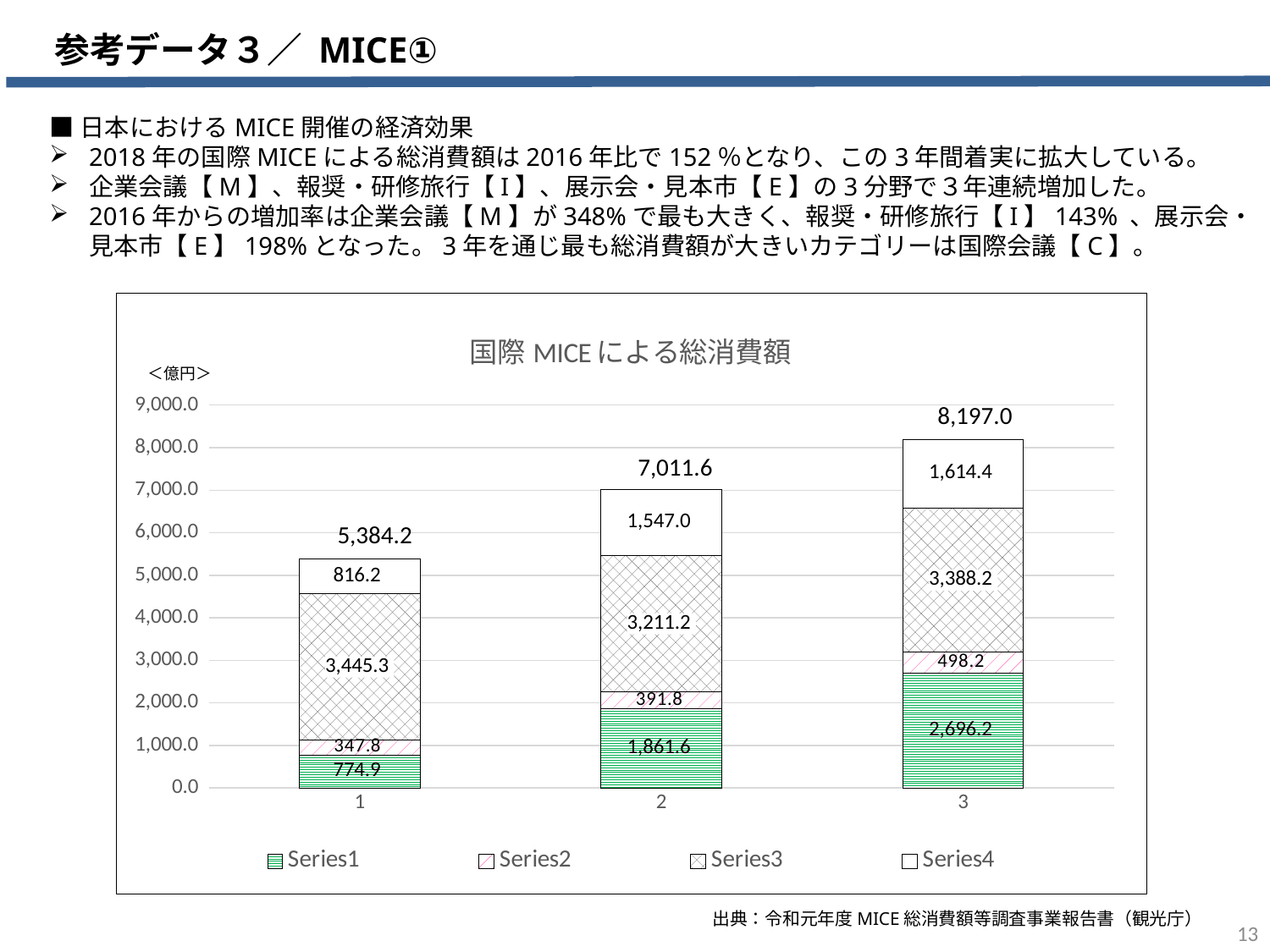
Do the totals rise or fall from category 1 to category 3? Rise How many categories are shown on the x axis? 3 How many series does the legend list? 4 What is the chart's title? 国際 MICE による総消費額 What is the value of Series3 for category 1? 3,445.3 What is the value of Series4 for category 2? 1,547.0 What is the value of Series1 for category 3? 2,696.2 What is the total of the stacked bar for category 2? 7,011.6 Which category has the lowest value for Series2? 1 Which category has the highest total? 3 What type of chart is shown on the slide? Stacked bar chart What is the difference between the totals for category 3 and category 1? 2,812.8